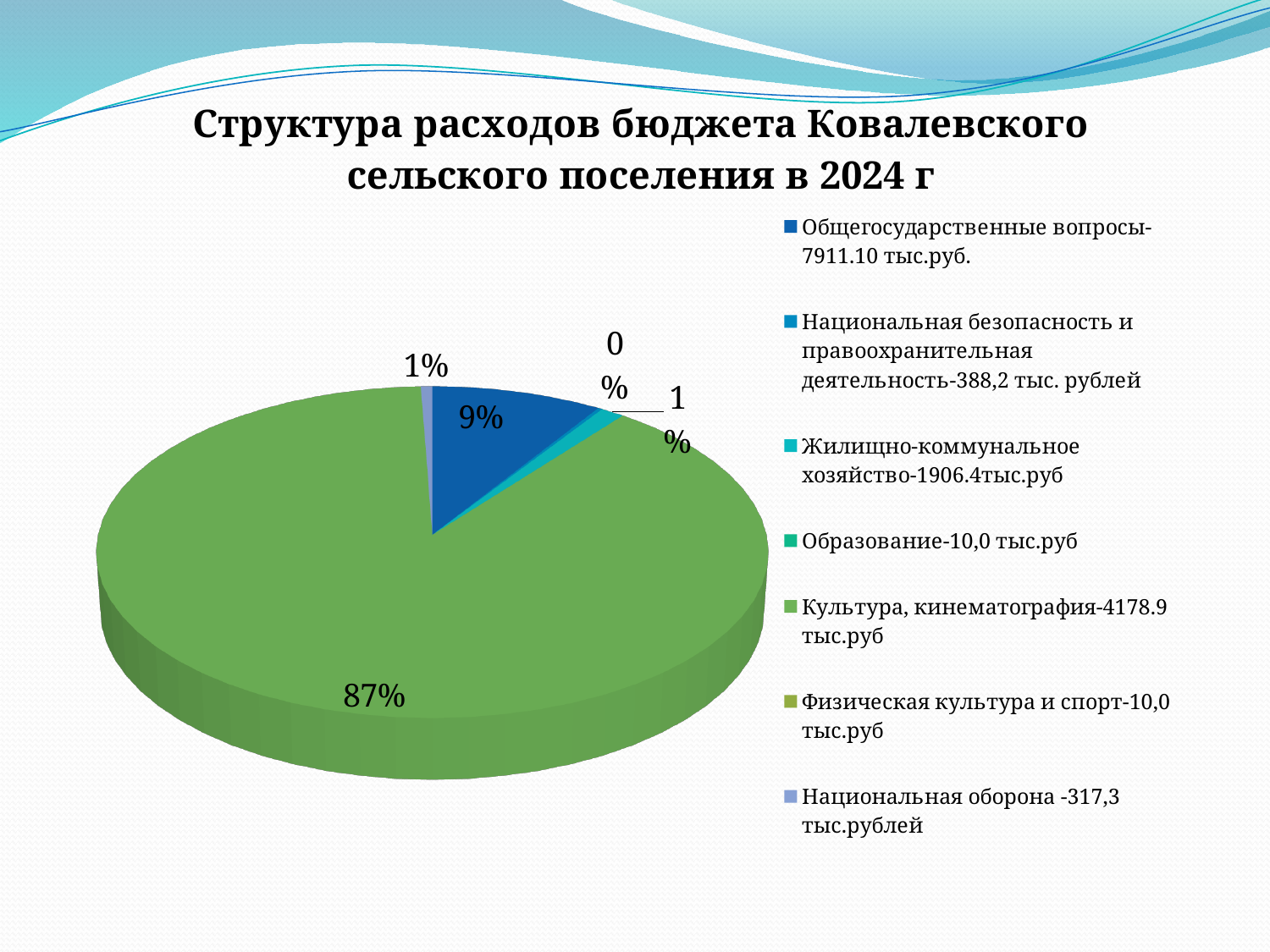
How many categories does the legend list? 7 According to the legend, what amount is given for Жилищно-коммунальное хозяйство? 1906.4 тыс.руб According to the legend, what amount is given for Общегосударственные вопросы? 7911.10 тыс.руб. Which is larger, the slice labelled 87% or the slice labelled 9%? the slice labelled 87% What is the title of the chart? Структура расходов бюджета Ковалевского сельского поселения в 2024 г What share of the pie is labelled for the dark blue slice (Общегосударственные вопросы)? 9% What colour is the slice labelled 87%? green What share of the pie does the largest slice (Культура, кинематография) take? 87% Which category has the largest slice of the pie? Культура, кинематография What is the difference in percentage points between the 87% slice and the 9% slice? 78% According to the legend, what amount is given for Национальная оборона? 317,3 тыс.рублей What kind of chart is shown on the slide? pie chart